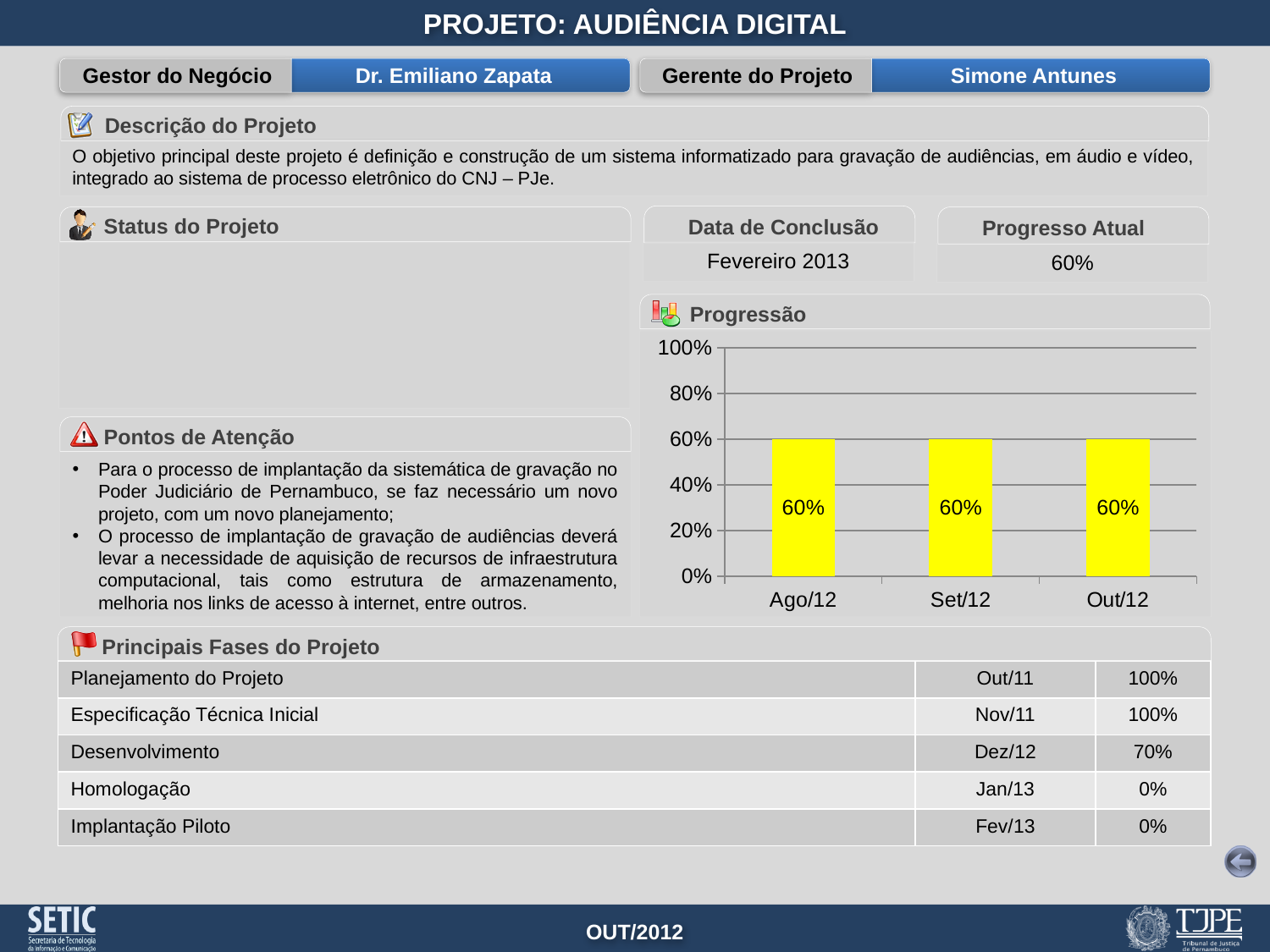
Is the value for Out/12 in the Progressão chart greater or less than 80%? less What is the difference between the values for Out/12 and Ago/12 in the Progressão chart? 0% What kind of chart is the Progressão chart? bar chart What is the value for Ago/12 in the Progressão chart? 60% What is the value for Set/12 in the Progressão chart? 60% What colour are the bars in the Progressão chart? yellow Do the values in the Progressão chart rise, fall or stay flat from Ago/12 to Out/12? stay flat How many bars are plotted in the Progressão chart? 3 Is the value for Set/12 in the Progressão chart greater or less than 40%? greater What is the value for Out/12 in the Progressão chart? 60% What is the highest value shown on the y axis of the Progressão chart? 100%